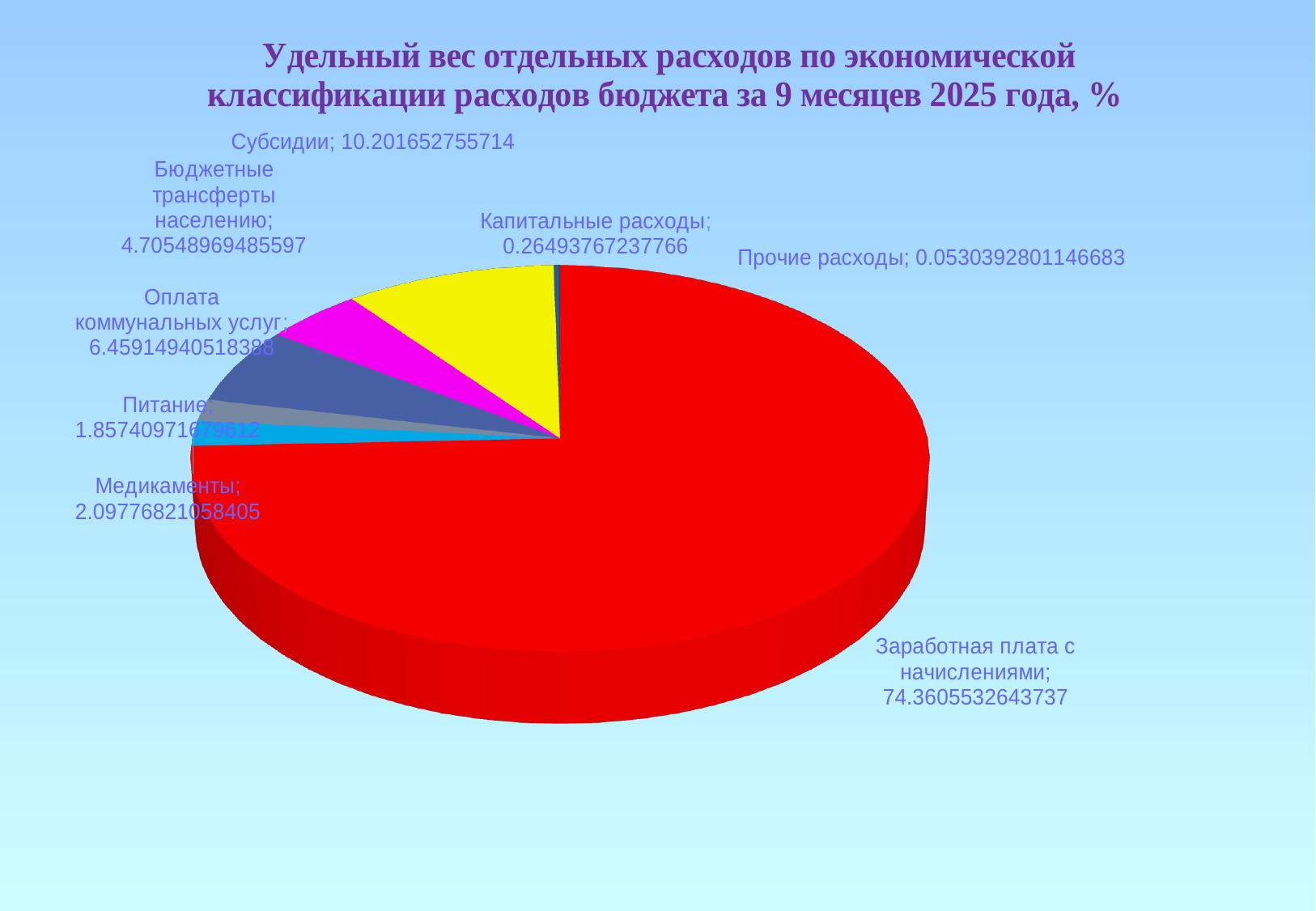
Which is larger, Субсидии or Медикаменты? Субсидии What colour is the slice for Заработная плата с начислениями? Red What is the value for Бюджетные трансферты населению? 4.70548969485597 How many categories are shown in the pie chart? 8 Which category has the smallest share of the pie? Прочие расходы What is the value for Медикаменты? 2.09776821058405 What kind of chart is shown on the slide? Pie chart What is the value for Заработная плата с начислениями? 74.3605532643737 What is the value for Субсидии? 10.201652755714 What is the value for Прочие расходы? 0.0530392801146683 What is the value for Капитальные расходы? 0.26493767237766 Which category has the largest share of the pie? Заработная плата с начислениями